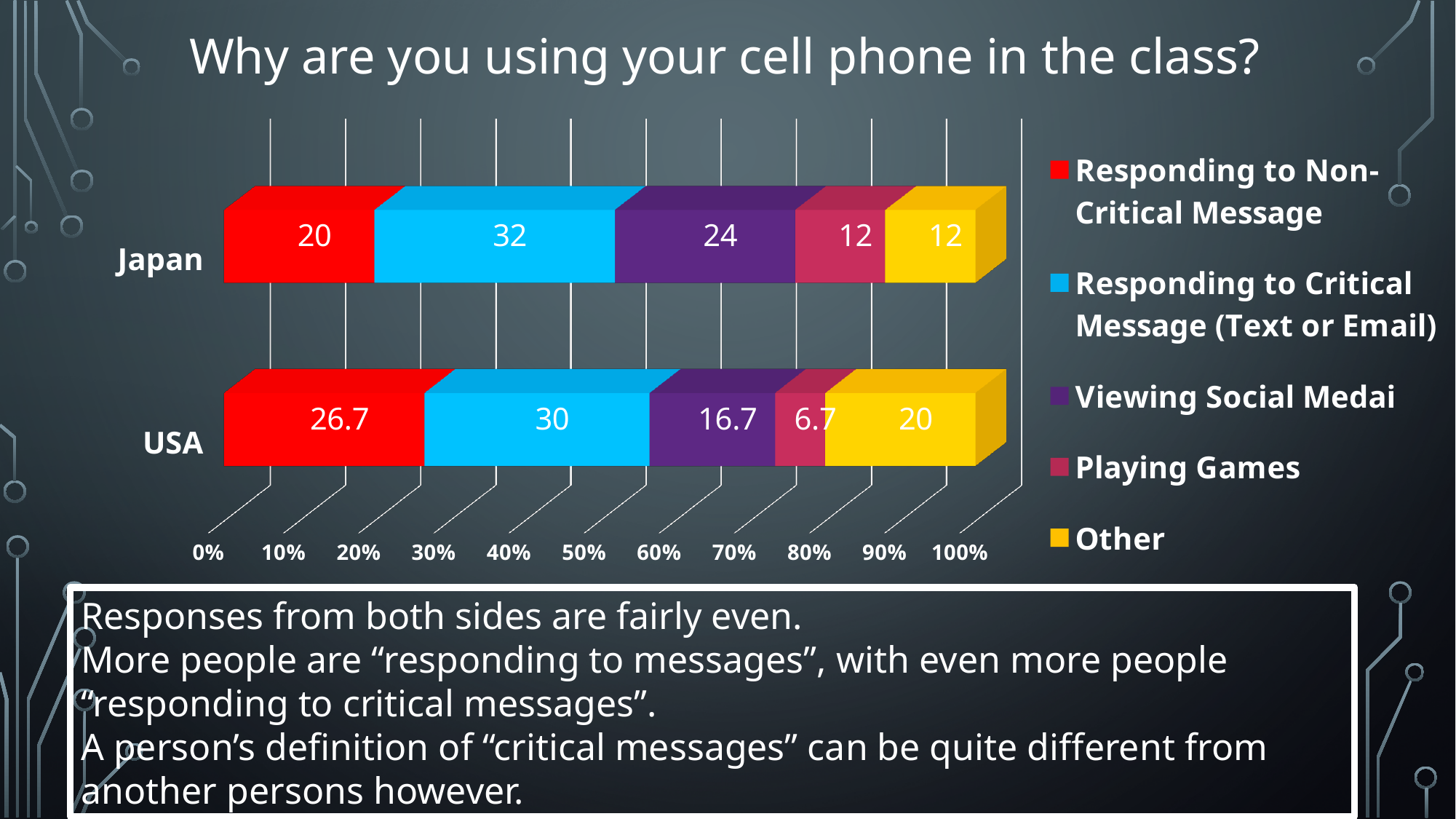
What is the value for Responding to Non-Critical Message for USA? 26.7 What is the value for Playing Games for USA? 6.7 Which series has the highest value for Japan? Responding to Critical Message (Text or Email) What is the difference between the Other values for USA and Japan? 8 How many series does the legend list? 5 What kind of chart is shown on the slide? Stacked bar chart What is the value for Viewing Social Medai for Japan? 24 Which is larger: Viewing Social Medai for Japan or Viewing Social Medai for USA? Japan Which series has the lowest value for USA? Playing Games How many countries are shown on the chart? 2 What is the value for Responding to Critical Message (Text or Email) for Japan? 32 What colour represents Other in the chart? Yellow